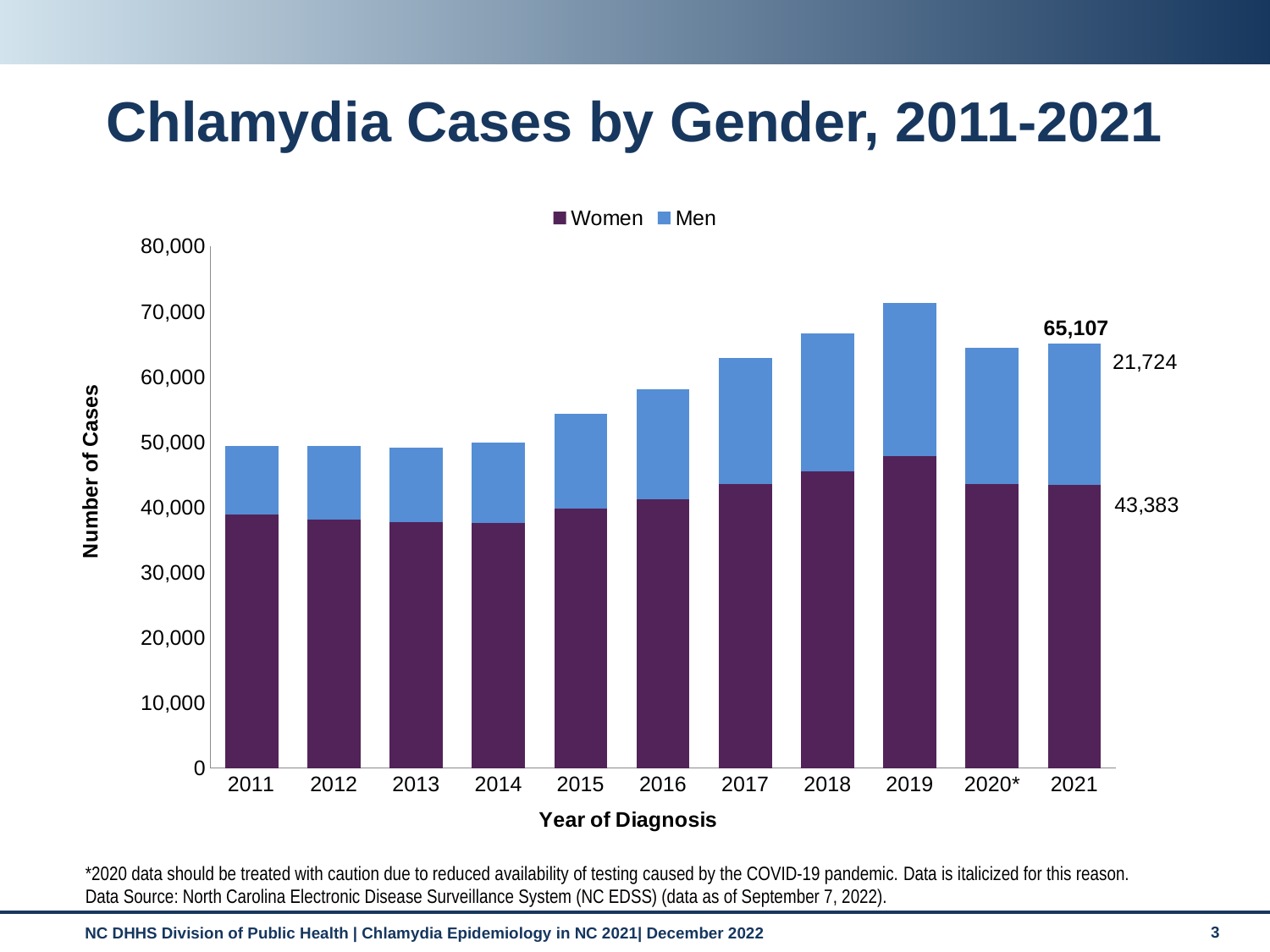
How many chlamydia cases among women are shown for 2021? 43,383 How many chlamydia cases among men are shown for 2021? 21,724 What is the label on the y axis? Number of Cases Is the total number of cases for 2017 greater or less than 60,000? greater In 2021, how many more cases were there among women than among men? 21,659 Which year has the highest total number of cases? 2019 What kind of chart is shown on the slide? Stacked bar chart Do the total cases generally rise or fall from 2011 to 2019? Rise In 2021, which group had more cases, women or men? Women What is the total number of chlamydia cases shown for 2021? 65,107 How many series does the legend list? 2 How many years are shown on the x axis? 11